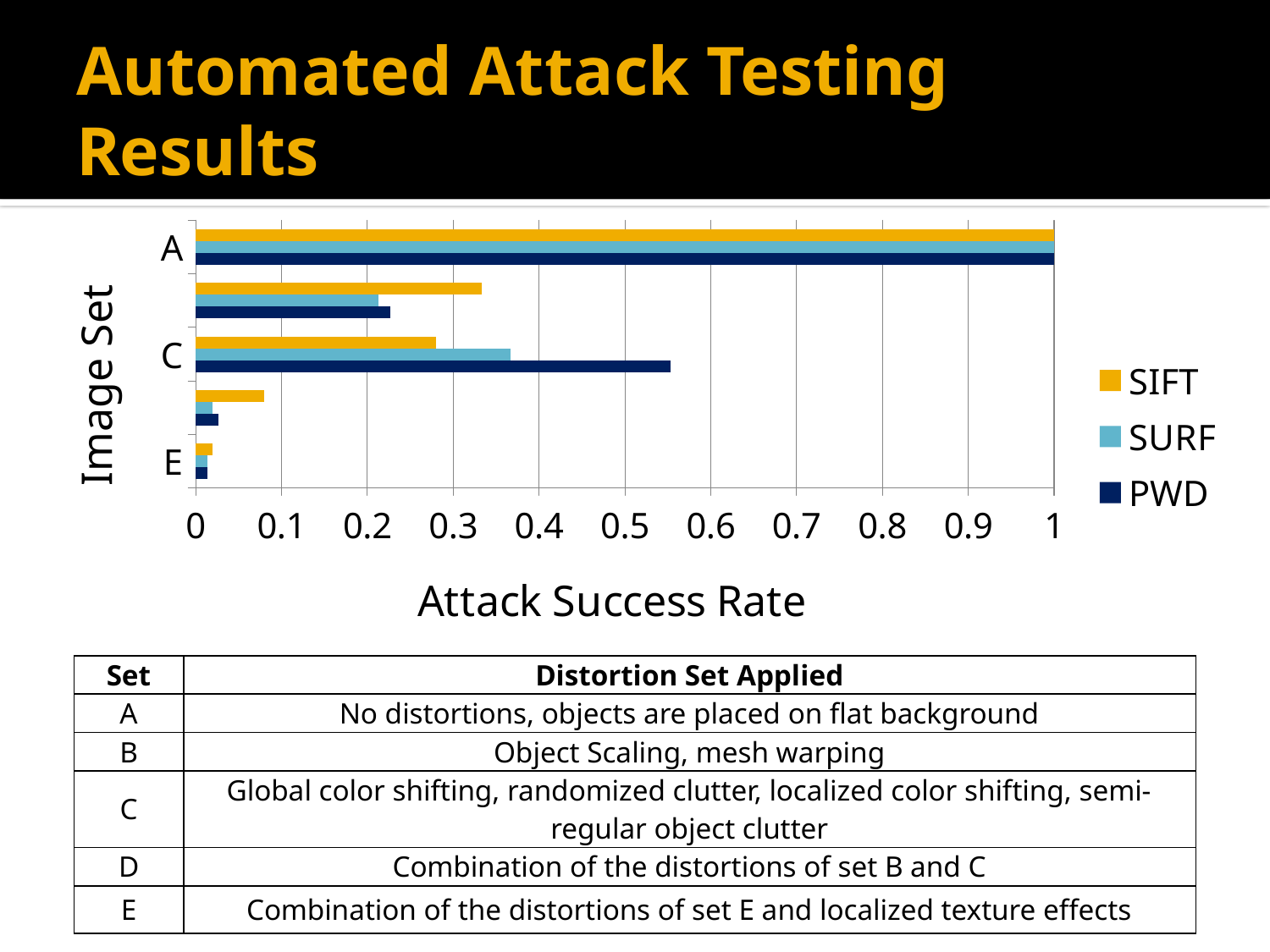
Is the attack success rate for SURF on image set C greater or less than 0.3? greater Is the attack success rate for PWD on image set C greater or less than 0.5? greater Which image set has the highest attack success rate for PWD? A Which image set has the lowest attack success rate for SIFT? E How many series does the chart's legend list? 3 What is the attack success rate for PWD on image set A? 1 Is the attack success rate for SIFT on image set C greater or less than 0.4? less What kind of chart is shown on the slide? bar chart What is the title of the chart's horizontal axis? Attack Success Rate What are the three series named in the chart's legend? SIFT, SURF, PWD On image set C, which has the larger attack success rate, PWD or SIFT? PWD What is the attack success rate for SIFT on image set A? 1